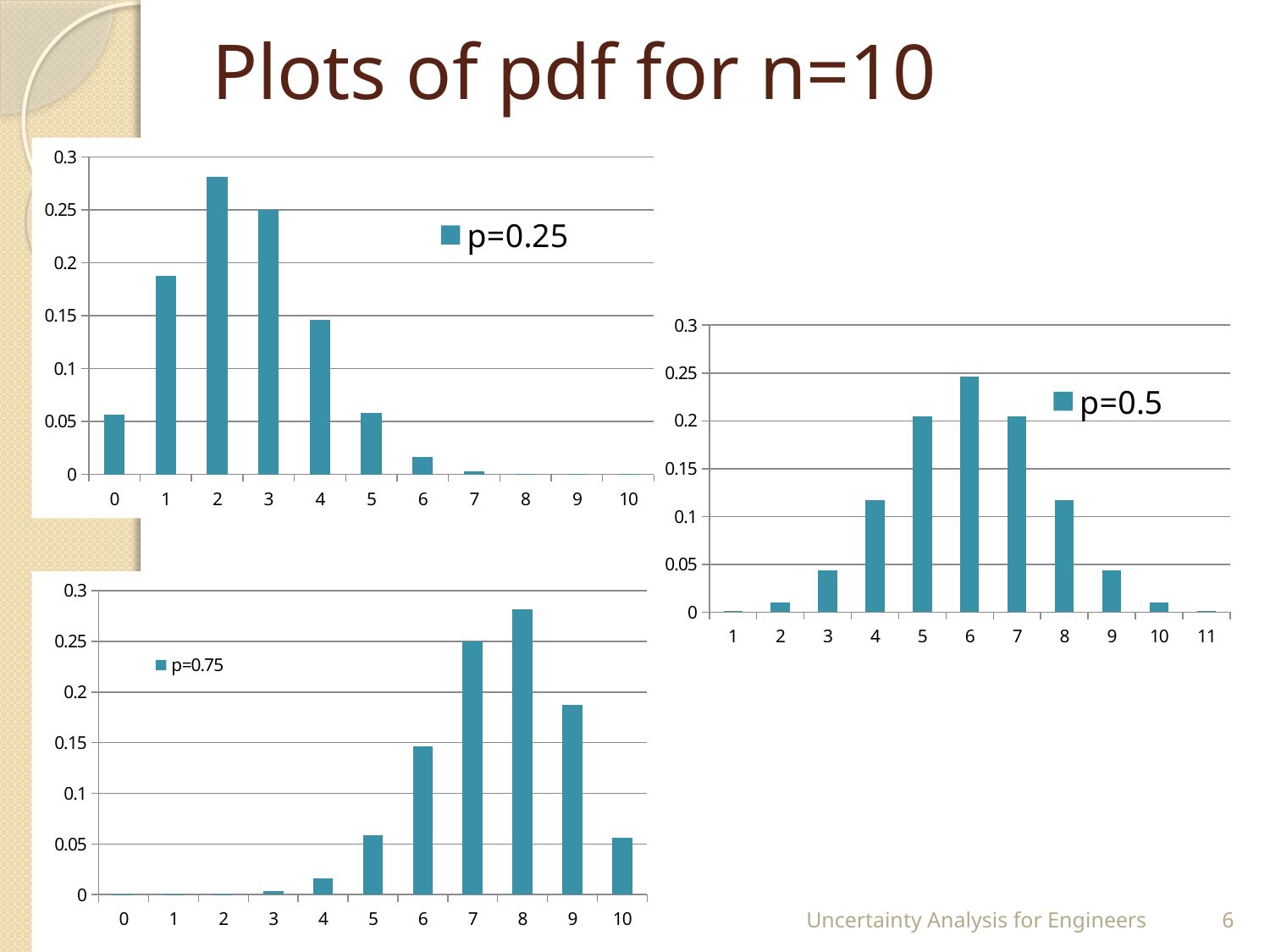
In the chart with legend p=0.25, which category has the highest bar? 2 In the chart with legend p=0.75, which category has the highest bar? 8 In the chart with legend p=0.5, which category has the highest bar? 6 How many series does the legend of the chart with legend p=0.5 list? 1 In the chart with legend p=0.75, is the value for category 5 greater or less than 0.1? less How many charts are shown on the slide? 3 How many categories are shown on the x axis of the chart with legend p=0.5? 11 How many categories are shown on the x axis of the chart with legend p=0.25? 11 In the chart with legend p=0.25, is the value for category 1 greater or less than 0.15? greater In the chart with legend p=0.5, is the value for category 4 greater or less than 0.1? greater In the chart with legend p=0.25, which is larger, the value for category 2 or category 3? category 2 What kind of chart is the chart with legend p=0.25? bar chart